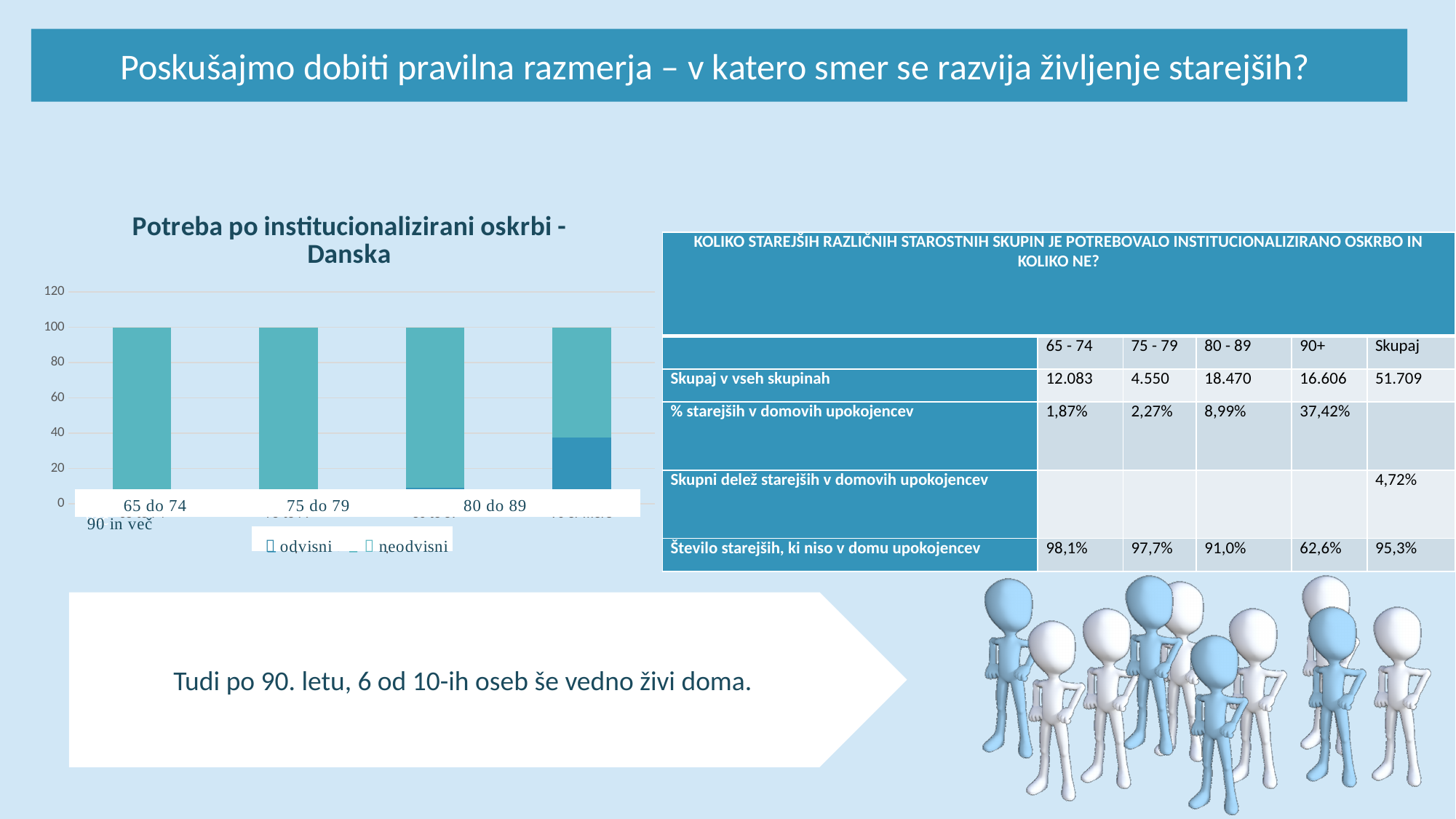
In the chart 'Potreba po institucionalizirani oskrbi - Danska', is the 'odvisni' value for '90 in več' greater or less than 20? greater In the chart 'Potreba po institucionalizirani oskrbi - Danska', is the 'neodvisni' value for '65 do 74' greater or less than 80? greater What kind of chart is 'Potreba po institucionalizirani oskrbi - Danska'? bar chart In the chart 'Potreba po institucionalizirani oskrbi - Danska', is the 'odvisni' portion larger for '90 in več' or for '65 do 74'? 90 in več How many age-group categories are shown on the x axis of the chart 'Potreba po institucionalizirani oskrbi - Danska'? 4 How many series does the legend of the chart 'Potreba po institucionalizirani oskrbi - Danska' list? 2 In the chart 'Potreba po institucionalizirani oskrbi - Danska', which age group has the largest 'odvisni' portion? 90 in več What are the two legend entries of the chart 'Potreba po institucionalizirani oskrbi - Danska'? odvisni, neodvisni In the chart 'Potreba po institucionalizirani oskrbi - Danska', what is the total height of each stacked bar? 100 In the chart 'Potreba po institucionalizirani oskrbi - Danska', does the 'odvisni' portion rise or fall as the age groups move from left to right? rise What is the highest value shown on the y axis of the chart 'Potreba po institucionalizirani oskrbi - Danska'? 120 In the chart 'Potreba po institucionalizirani oskrbi - Danska', which age group has the smallest 'neodvisni' portion? 90 in več